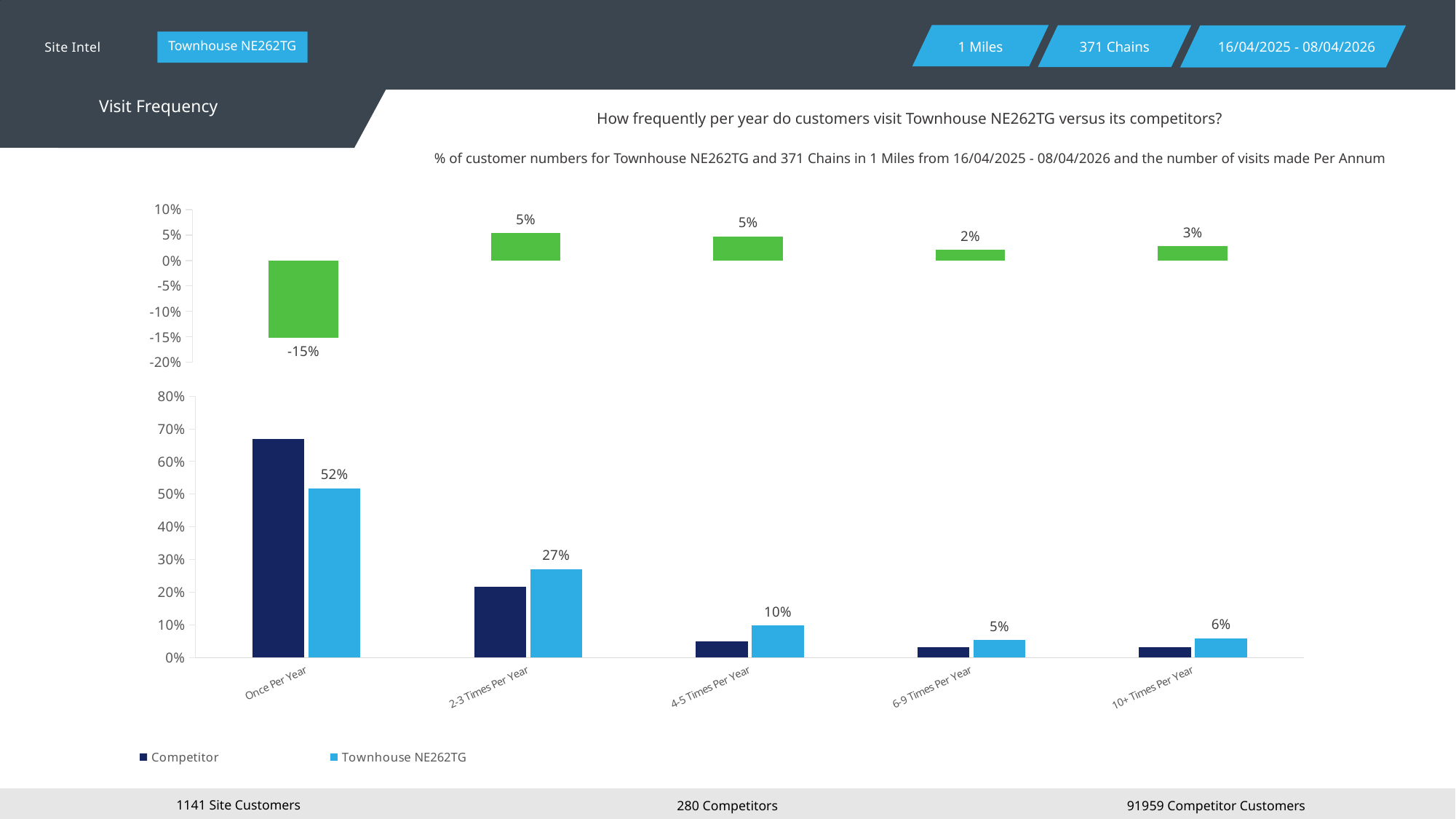
In the bottom chart, which is larger for 2-3 Times Per Year: Competitor or Townhouse NE262TG? Townhouse NE262TG How many series does the legend of the bottom chart list? 2 In the top chart, what is the value for 6-9 Times Per Year? 2% In the bottom chart, what is the value for Townhouse NE262TG for 2-3 Times Per Year? 27% In the bottom chart, what is the value for Townhouse NE262TG for Once Per Year? 52% In the top chart, what is the value for Once Per Year? -15% In the top chart, which category has the lowest value? Once Per Year In the bottom chart, which category has the highest Townhouse NE262TG value? Once Per Year In the bottom chart, what is the value for Townhouse NE262TG for 4-5 Times Per Year? 10% How many categories are shown on the x axis of the bottom chart? 5 In the bottom chart, is the Competitor value for Once Per Year greater or less than 60%? greater In the bottom chart, what is the difference between the Townhouse NE262TG values for Once Per Year and 2-3 Times Per Year? 25%